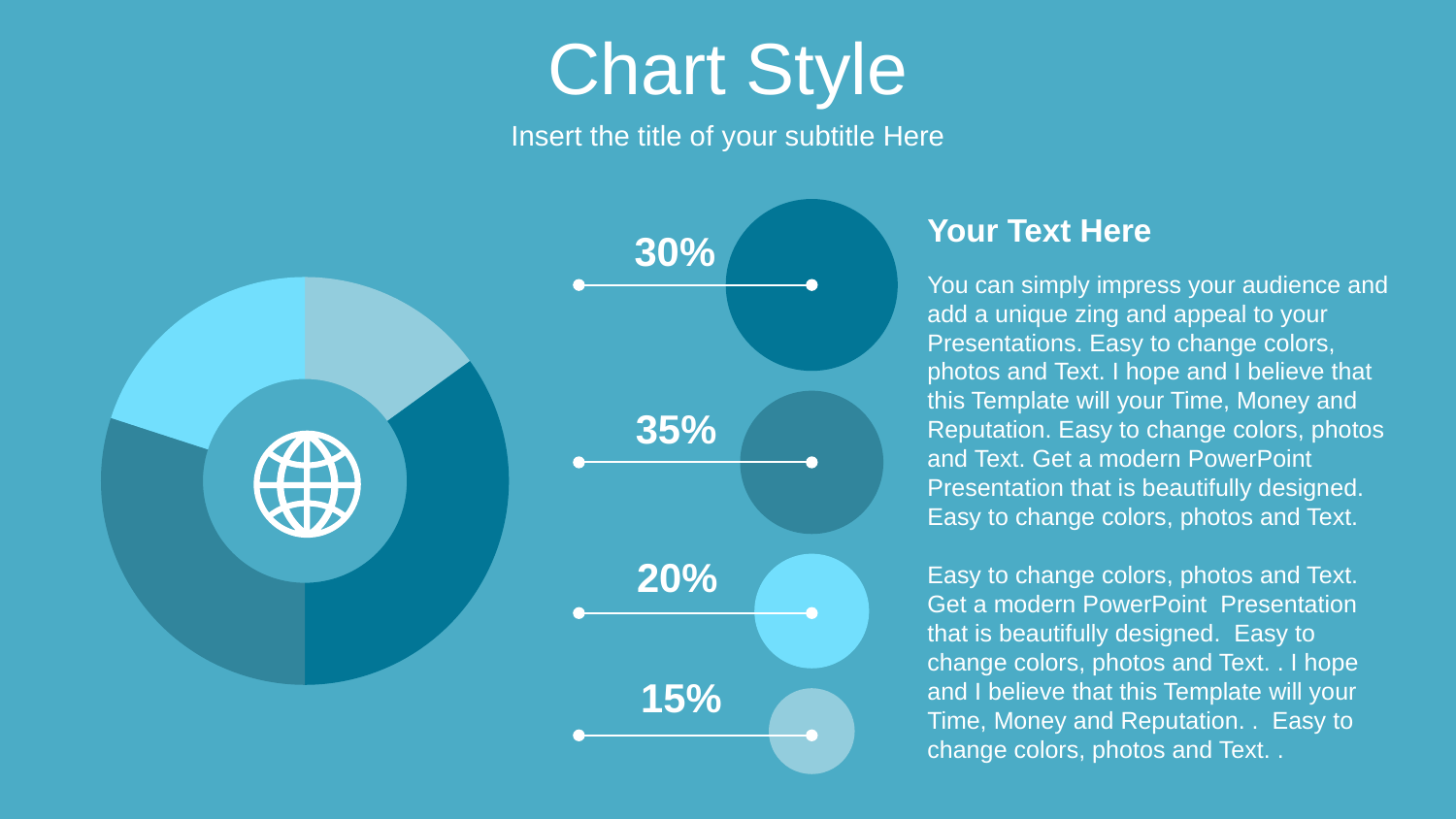
What percentage is shown next to the pale blue circle at the bottom? 15% What percentage is shown next to the darkest teal circle at the top? 30% What is the smallest percentage shown next to the circles? 15% What percentage is shown next to the light cyan circle? 20% What kind of chart is shown on the left of the slide? pie chart (donut) What is the difference between the 35% value and the 15% value? 20% What is the title of the slide containing the chart? Chart Style What is the largest percentage shown next to the circles? 35% What do the four percentages shown on the slide add up to? 100% Which is larger, the value for the dark teal circle or the value for the medium teal circle? medium teal (35%) How many slices does the donut chart have? 4 What icon is shown in the centre of the donut chart? a globe